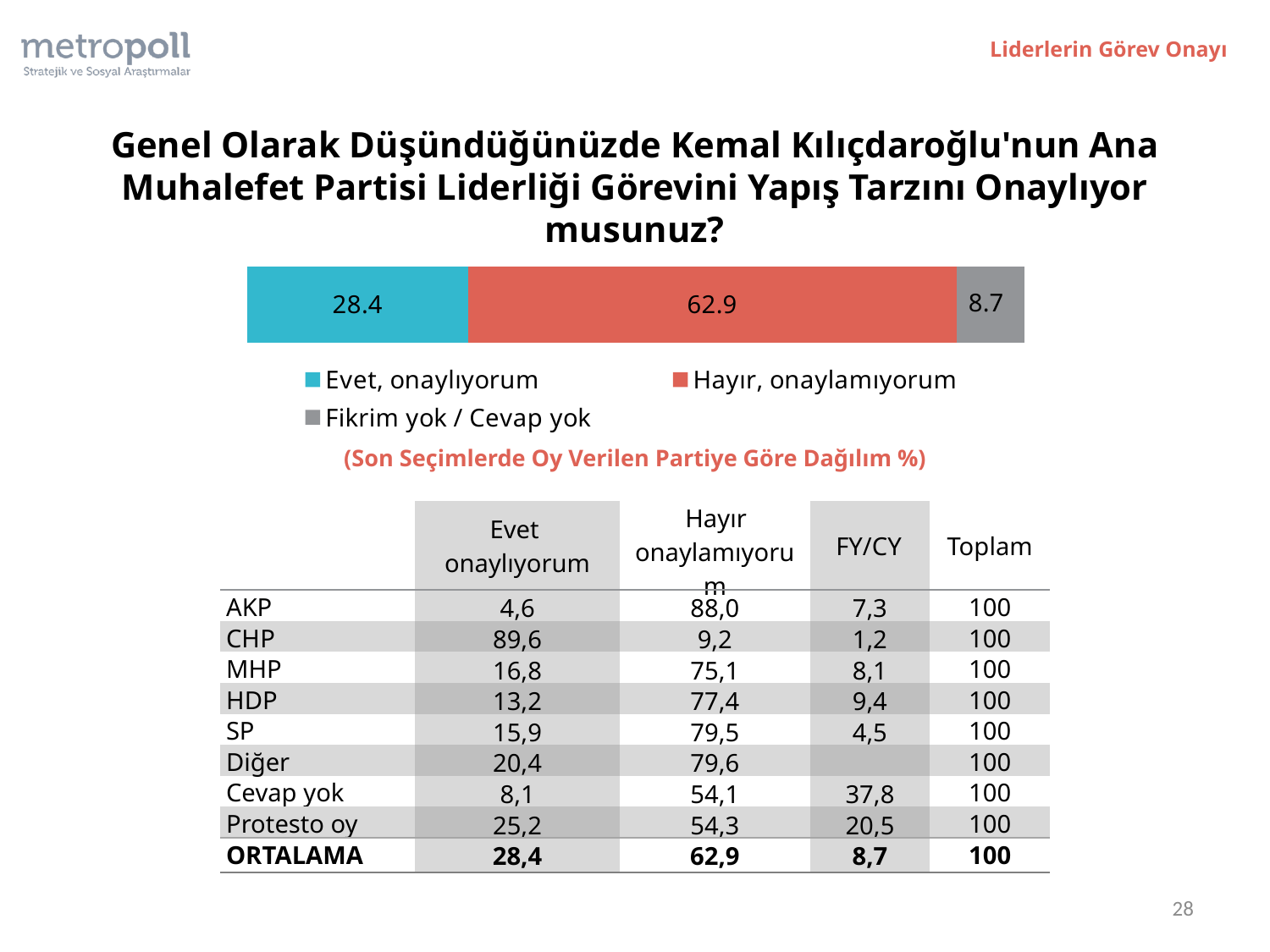
What value is shown for the "Hayır, onaylamıyorum" segment of the bar? 62.9 Which legend category has the smallest segment in the bar? Fikrim yok / Cevap yok Which is larger in the bar: "Evet, onaylıyorum" or "Fikrim yok / Cevap yok"? Evet, onaylıyorum How many series does the chart legend list? 3 What is the total of the three segments in the stacked bar? 100 What value is shown for the "Fikrim yok / Cevap yok" segment of the bar? 8.7 What kind of chart is shown on the slide? Stacked bar chart What is the difference between the "Hayır, onaylamıyorum" and "Evet, onaylıyorum" values in the bar? 34.5 What value is shown for the "Evet, onaylıyorum" segment of the bar? 28.4 What colour is the "Evet, onaylıyorum" segment of the bar? Teal/blue What colour is the "Hayır, onaylamıyorum" segment of the bar? Red Which legend category has the largest segment in the bar? Hayır, onaylamıyorum